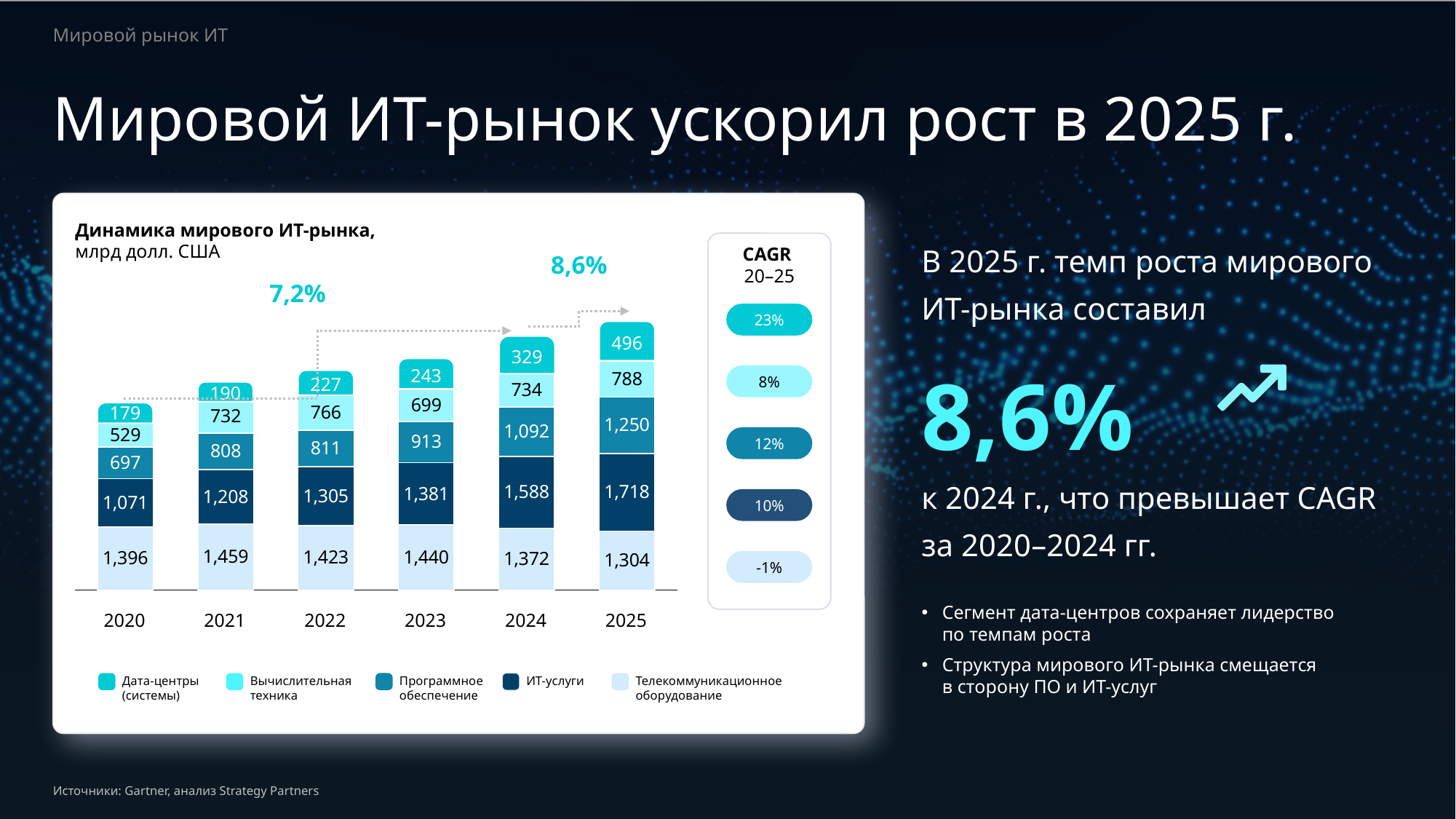
How many series does the legend list? 5 What is the value for IT services (ИТ-услуги) in 2025? 1,718 In which year is the telecommunications equipment (Телекоммуникационное оборудование) segment lowest? 2025 What is the difference between the data centres (Дата-центры) values in 2025 and 2024? 167 Which is larger: computing hardware (Вычислительная техника) in 2022 or in 2023? 2022 What is the total of the stacked bar for 2025? 5,556 What kind of chart is shown? Stacked bar chart What is the value for data centres (Дата-центры (системы)) in 2020? 179 How many years are shown on the x axis? 6 In which year is the software (Программное обеспечение) segment highest? 2025 What growth rate is annotated above the 2025 bar? 8,6% What is the value for telecommunications equipment (Телекоммуникационное оборудование) in 2023? 1,440